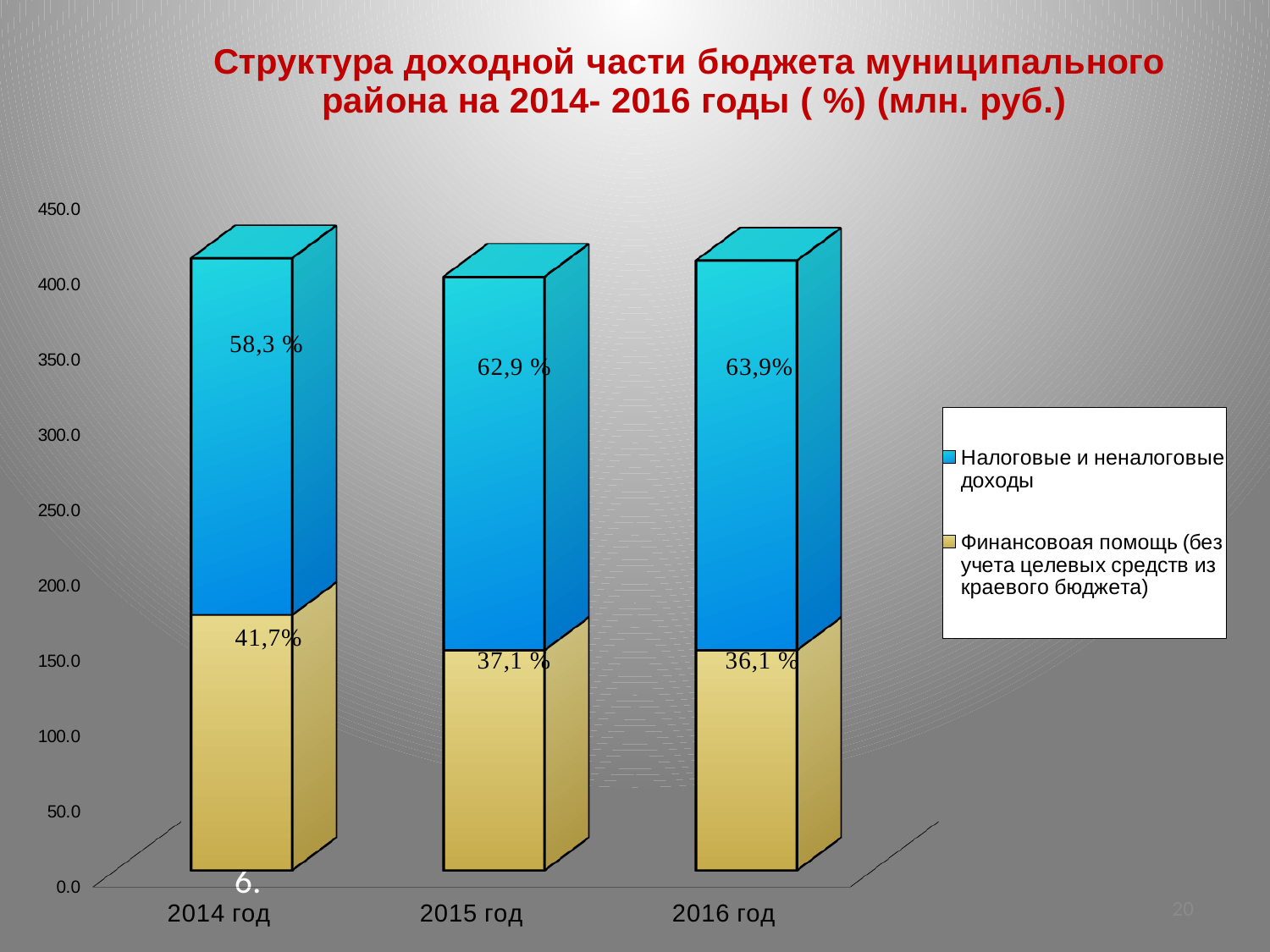
How many years (categories) are shown on the x axis? 3 How many series does the legend list? 2 What percentage label is shown for Финансовоая помощь in 2015 год? 37,1 % In which year is the labelled share of Финансовоая помощь the lowest? 2016 год What percentage label is shown for Налоговые и неналоговые доходы in 2014 год? 58,3 % Is the total height of the 2014 год bar greater or less than 400.0? greater What percentage label is shown for Налоговые и неналоговые доходы in 2016 год? 63,9% Which is larger in 2015 год: the share of Налоговые и неналоговые доходы or the share of Финансовоая помощь? Налоговые и неналоговые доходы Does the labelled share of Налоговые и неналоговые доходы rise or fall from 2014 год to 2016 год? rise What percentage label is shown for Финансовоая помощь in 2014 год? 41,7% What kind of chart is shown on the slide? stacked bar chart In which year is the labelled share of Налоговые и неналоговые доходы the highest? 2016 год